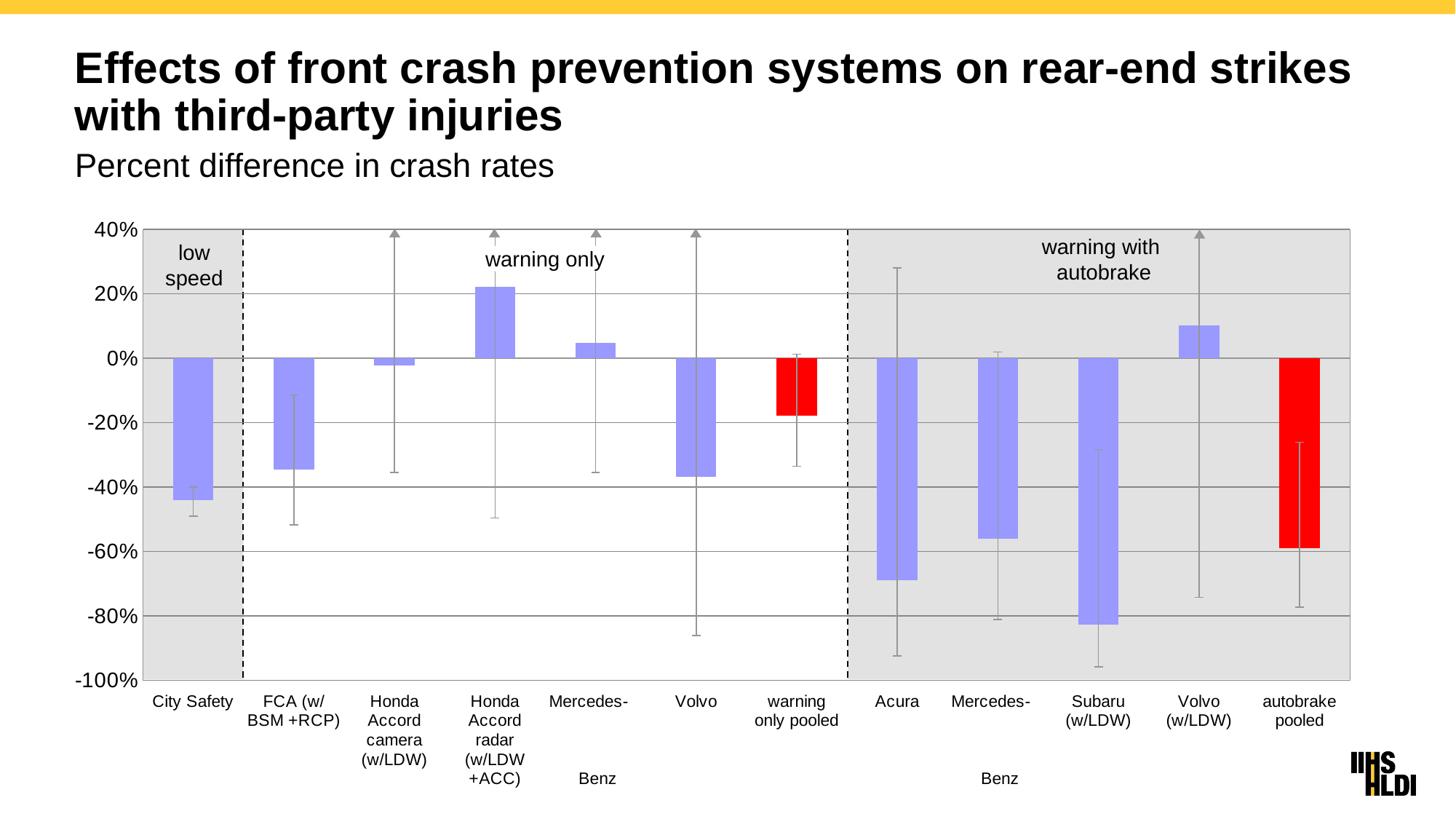
Which category has the lowest value? Subaru (w/LDW) Is the value for Subaru (w/LDW) greater or less than -60%? less What kind of chart is shown on the slide? bar chart Is the value for Volvo (w/LDW) greater or less than 0%? greater How many categories are plotted along the x axis? 12 Which is larger, the value for City Safety or the value for FCA (w/ BSM +RCP)? FCA (w/ BSM +RCP) Is the value for City Safety greater or less than -20%? less Which is larger, the value for Acura or the value for Mercedes-Benz in the warning with autobrake group? Mercedes-Benz What are the three group labels shown inside the chart area? low speed, warning only, warning with autobrake Which two categories are drawn with red bars? warning only pooled and autobrake pooled Which category has the highest value? Honda Accord radar (w/LDW +ACC)